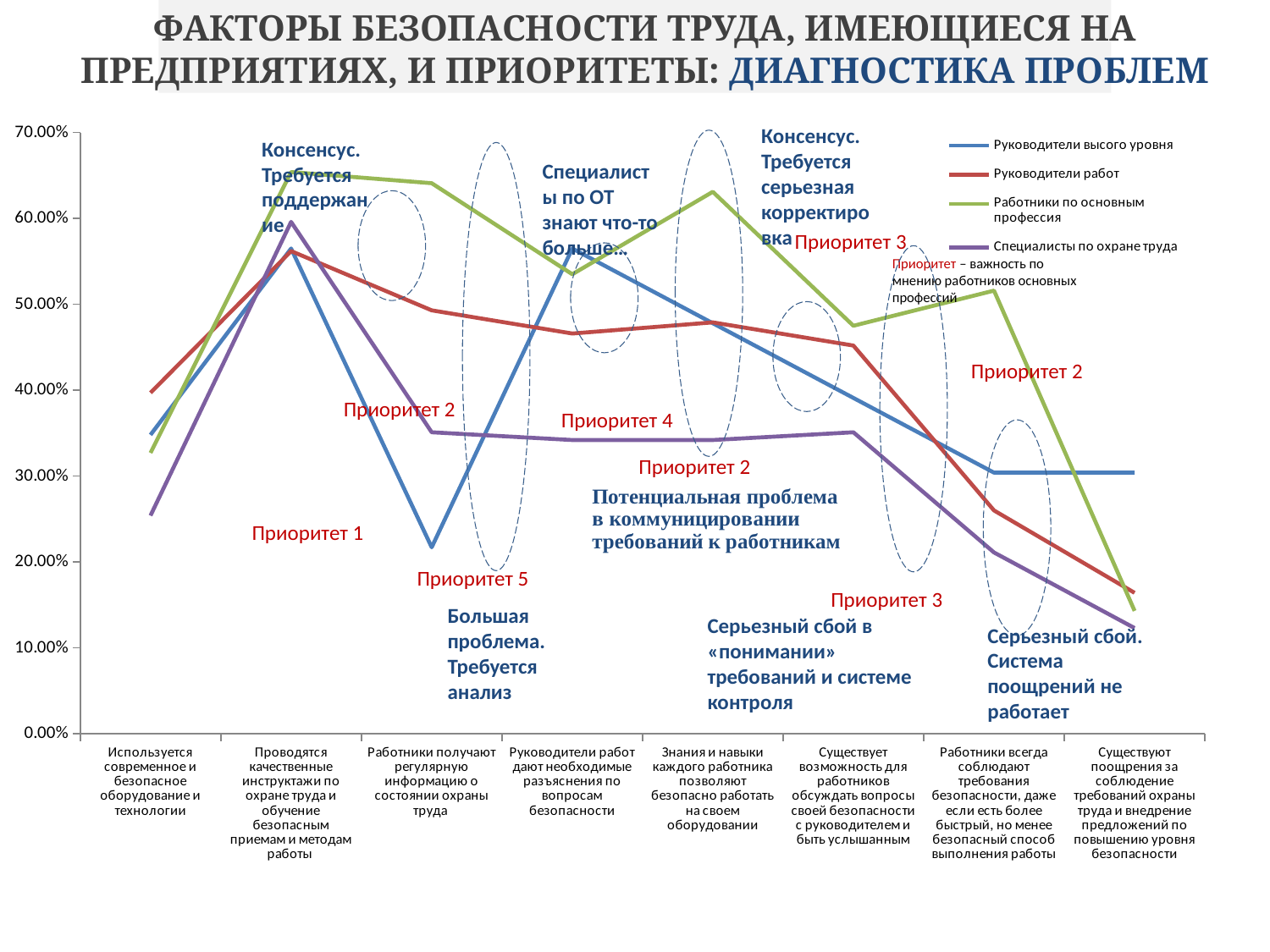
For which category is the "Специалисты по охране труда" line at its highest? Проводятся качественные инструктажи по охране труда и обучение безопасным приемам и методам работы How many categories are plotted along the x axis? 8 Is the value for "Специалисты по охране труда" at "Используется современное и безопасное оборудование и технологии" greater or less than 30.00%? less For which category is the "Работники по основным профессия" line at its lowest? Существуют поощрения за соблюдение требований охраны труда и внедрение предложений по повышению уровня безопасности Does the "Руководители работ" line rise or fall across the last three categories on the x axis? fall Is the value for "Работники по основным профессия" at "Проводятся качественные инструктажи по охране труда и обучение безопасным приемам и методам работы" greater or less than 60.00%? greater At "Работники получают регулярную информацию о состоянии охраны труда", which series has the higher value: "Руководители высокого уровня" or "Работники по основным профессия"? Работники по основным профессия For which category is the "Руководители высокого уровня" line at its lowest? Работники получают регулярную информацию о состоянии охраны труда At "Существуют поощрения за соблюдение требований охраны труда и внедрение предложений по повышению уровня безопасности", which series has the higher value: "Руководители высокого уровня" or "Руководители работ"? Руководители высокого уровня Is the value for "Руководители высокого уровня" at "Работники получают регулярную информацию о состоянии охраны труда" greater or less than 30.00%? less How many series does the legend list? 4 What kind of chart is shown on the slide? Line chart